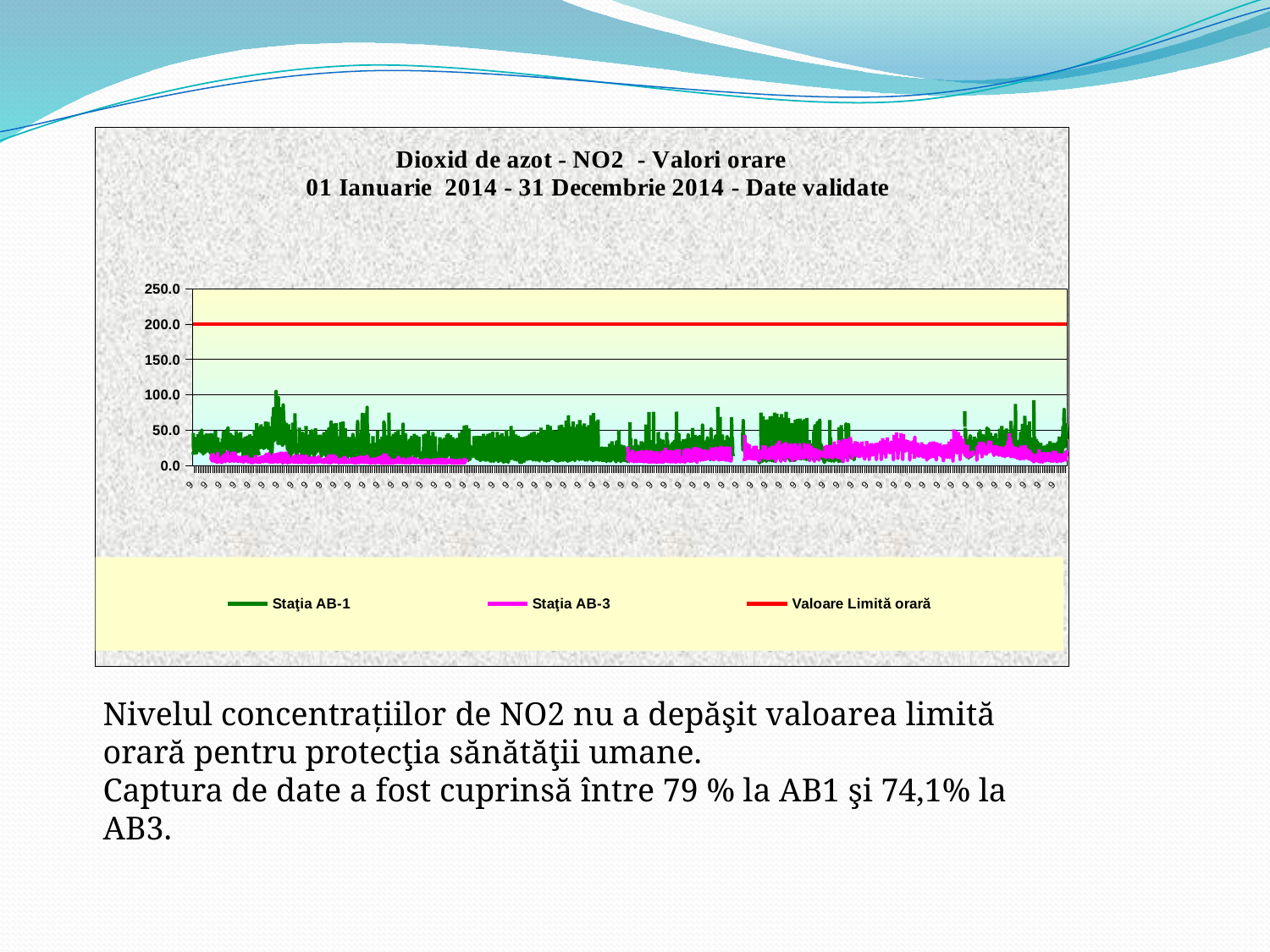
At what value on the y axis does the Valoare Limită orară line sit? 200.0 Is the highest value reached by Staţia AB-3 greater or less than 100.0? less What is the highest tick value shown on the y axis? 250.0 How many series does the legend list? 3 Which station shows generally higher NO2 values across the year, Staţia AB-1 or Staţia AB-3? Staţia AB-1 What is the title of the chart? Dioxid de azot - NO2 - Valori orare 01 Ianuarie 2014 - 31 Decembrie 2014 - Date validate What are the three series named in the legend? Staţia AB-1, Staţia AB-3, Valoare Limită orară Do the values of Staţia AB-1 ever exceed the Valoare Limită orară line? No Is the highest value reached by Staţia AB-1 greater or less than 150.0? less What is the lowest tick value shown on the y axis? 0.0 What kind of chart is shown on the slide? line chart Is the Valoare Limită orară line greater or less than 150.0? greater